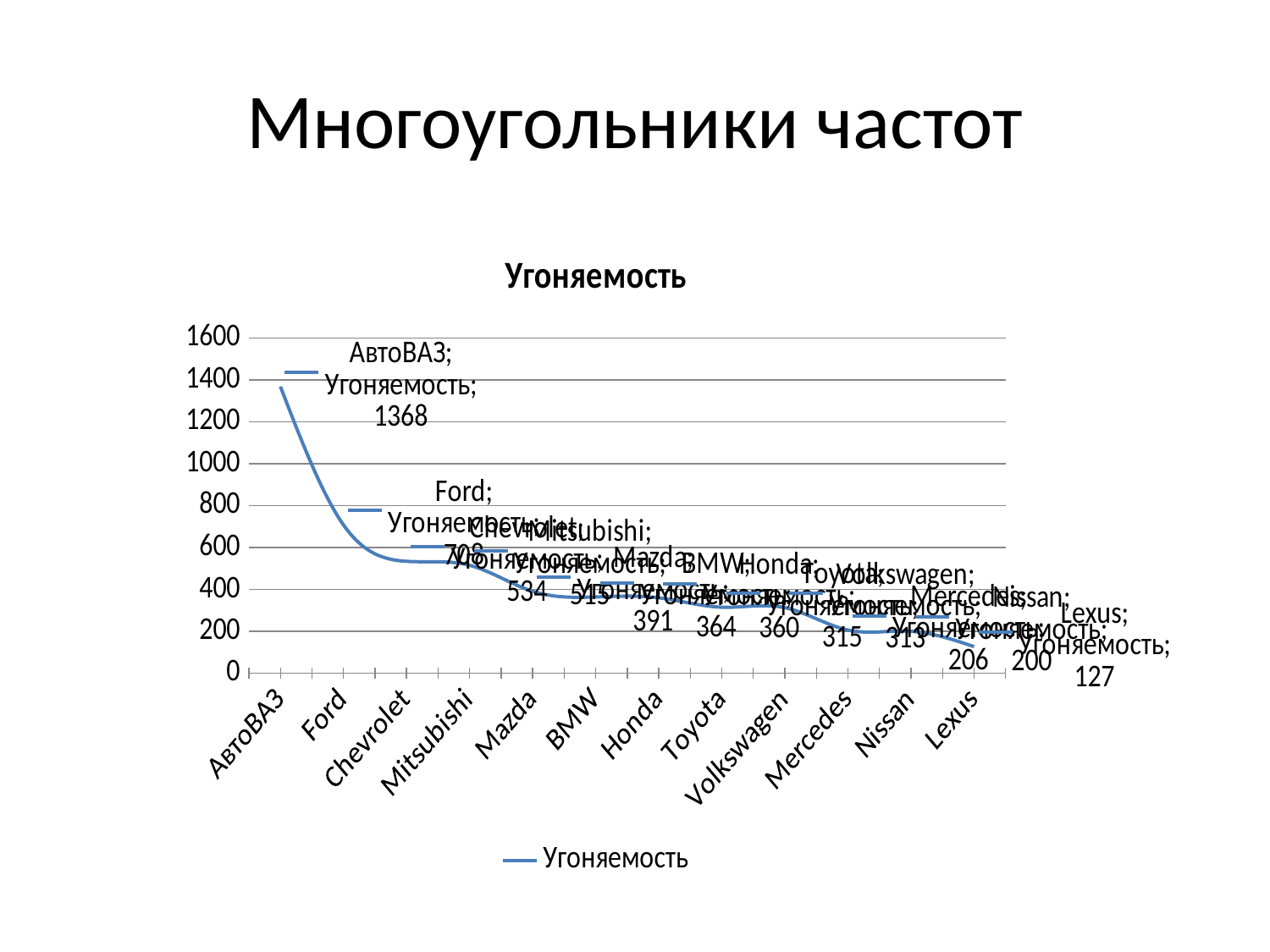
Do the values rise or fall from left to right along the x axis? fall How many car brands are plotted along the x axis? 12 Is the value for Chevrolet greater or less than 600? less What is the title of the chart? Угоняемость What is the value for Lexus? 127 What kind of chart is shown on the slide? line chart What is the difference between the values for АвтоВАЗ and Lexus? 1241 Which brand has the highest value? АвтоВАЗ What is the value for АвтоВАЗ? 1368 Which brand has the lowest value? Lexus Which is larger, the value for АвтоВАЗ or the value for Ford? АвтоВАЗ How many series does the legend list? 1